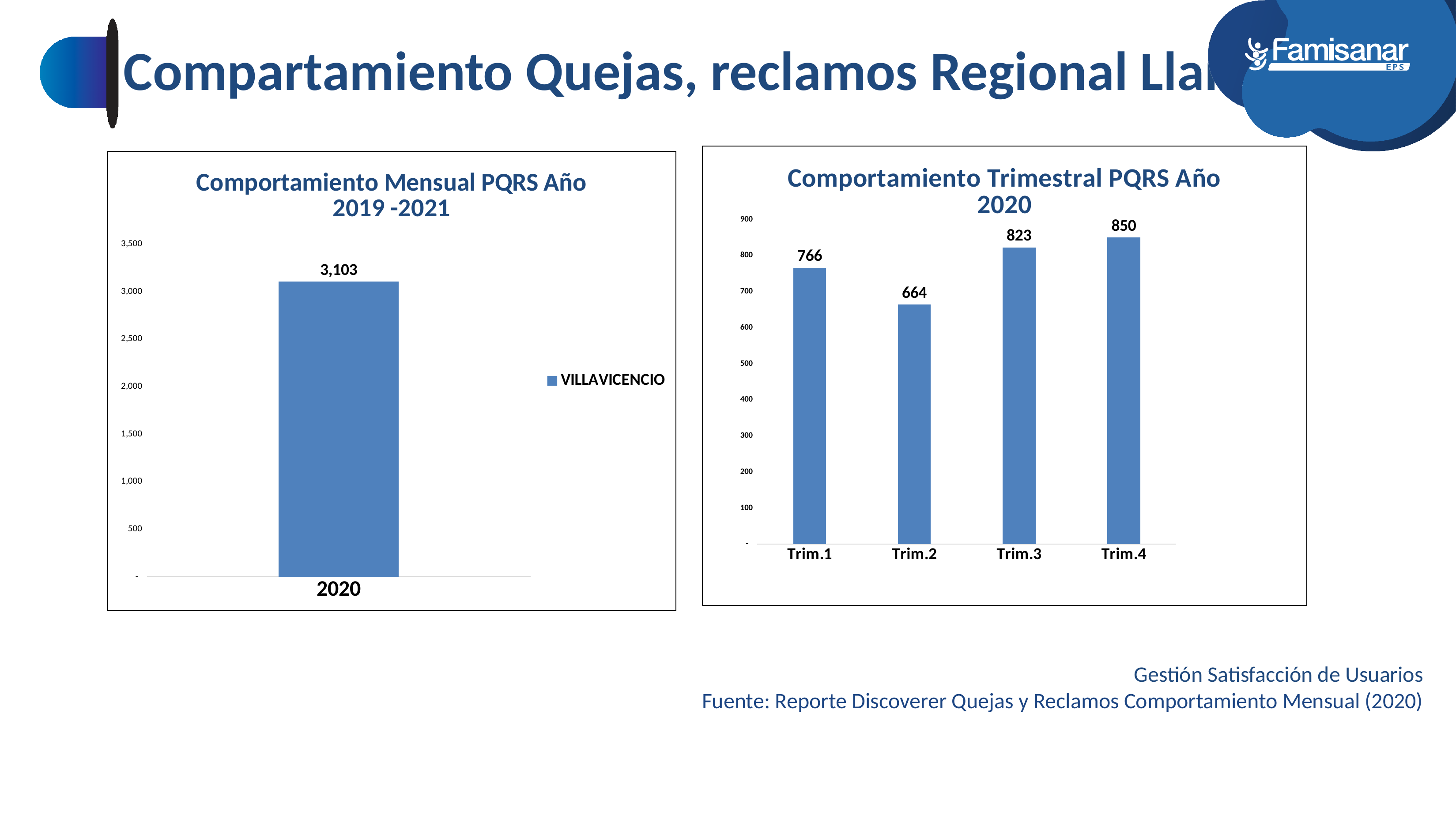
In the chart 'Comportamiento Trimestral PQRS Año 2020', what is the value for Trim.2? 664 In the chart 'Comportamiento Trimestral PQRS Año 2020', how many quarters are plotted? 4 In the chart 'Comportamiento Mensual PQRS Año 2019 -2021', what is the value for VILLAVICENCIO in 2020? 3,103 In the chart 'Comportamiento Trimestral PQRS Año 2020', which quarter has the lowest value? Trim.2 In the chart 'Comportamiento Mensual PQRS Año 2019 -2021', how many series does the legend list? 1 In the chart 'Comportamiento Trimestral PQRS Año 2020', what is the difference between Trim.3 and Trim.1? 57 In the chart 'Comportamiento Trimestral PQRS Año 2020', what is the total of the four quarterly values? 3,103 In the chart 'Comportamiento Mensual PQRS Año 2019 -2021', what is the name of the series in the legend? VILLAVICENCIO In the chart 'Comportamiento Trimestral PQRS Año 2020', which is larger, Trim.1 or Trim.2? Trim.1 In the chart 'Comportamiento Mensual PQRS Año 2019 -2021', what kind of chart is shown? bar chart In the chart 'Comportamiento Trimestral PQRS Año 2020', what is the value for Trim.4? 850 In the chart 'Comportamiento Trimestral PQRS Año 2020', which quarter has the highest value? Trim.4